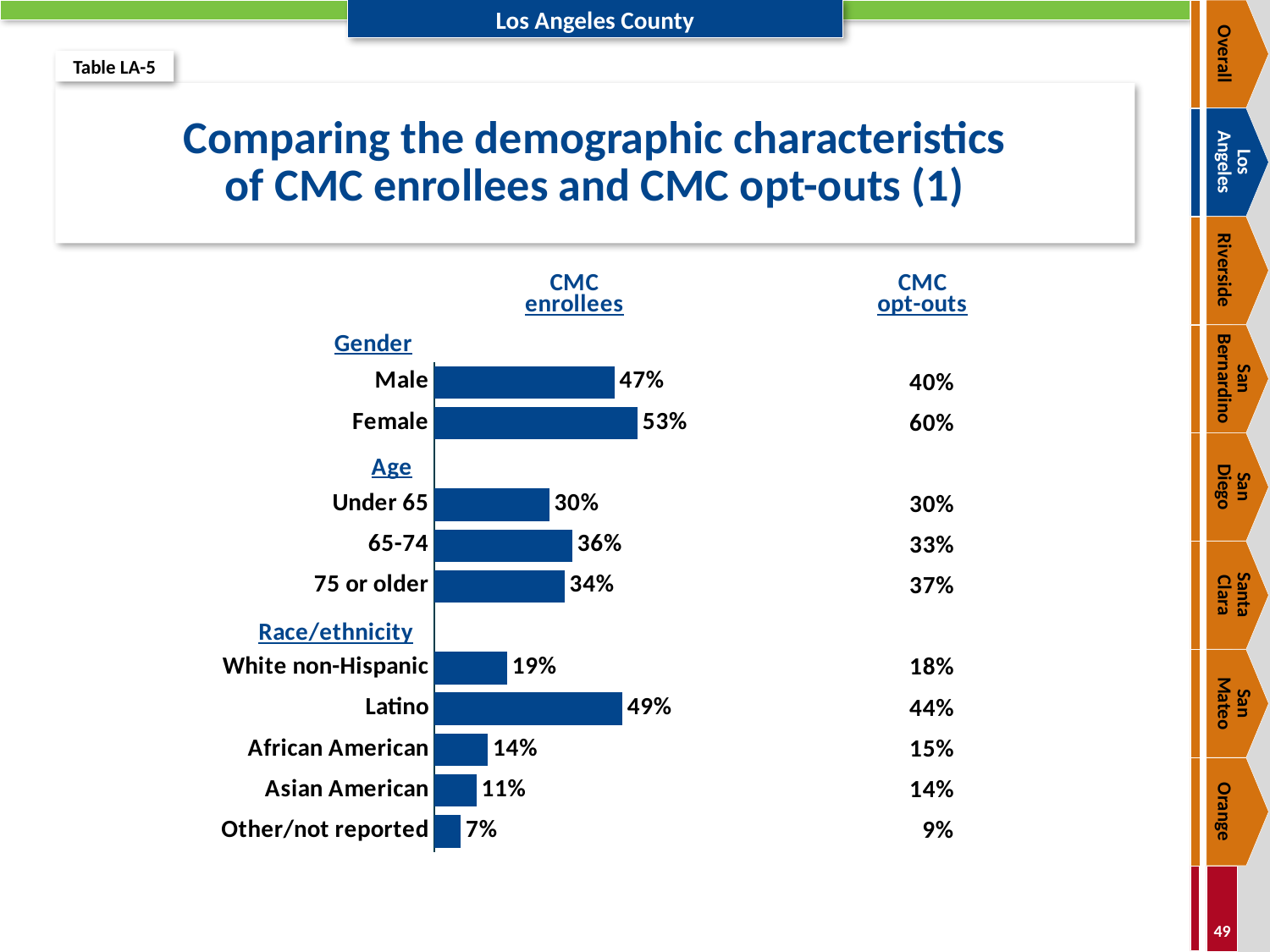
Which is larger for CMC enrollees: the share aged 65-74 or the share aged 75 or older? 65-74 Which race/ethnicity category has the lowest share among CMC enrollees? Other/not reported What type of chart is used to show the CMC enrollees data? Bar chart What percentage of CMC enrollees are Male? 47% What percentage of CMC enrollees are Latino? 49% Which race/ethnicity category has the highest share among CMC enrollees? Latino What is the difference between the Female and Male percentages for CMC enrollees? 6% What is the title of the slide? Comparing the demographic characteristics of CMC enrollees and CMC opt-outs (1) What percentage of CMC opt-outs are Female? 60% How many bars are plotted in the CMC enrollees chart? 10 What percentage of CMC enrollees are aged 65-74? 36% What is the difference between the Latino percentages for CMC enrollees and CMC opt-outs? 5%